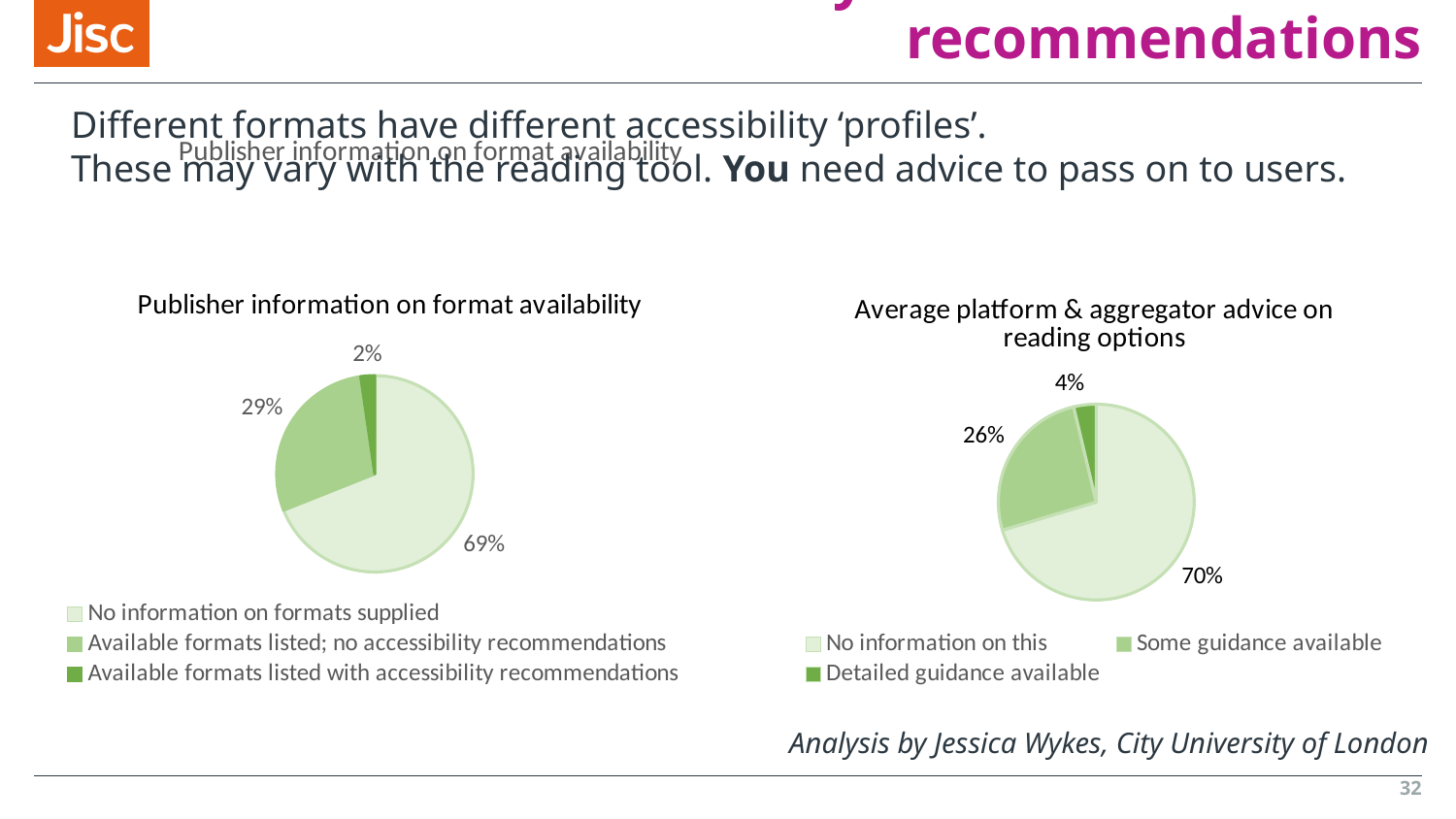
In the 'Publisher information on format availability' chart, which category has the smallest slice? Available formats listed with accessibility recommendations In the 'Publisher information on format availability' chart, how many categories does the legend list? 3 In the 'Average platform & aggregator advice on reading options' chart, what percentage is shown for 'Some guidance available'? 26% In the 'Average platform & aggregator advice on reading options' chart, what is the difference in percentage points between 'No information on this' and 'Some guidance available'? 44 In the 'Publisher information on format availability' chart, what percentage is shown for 'Available formats listed; no accessibility recommendations'? 29% What kind of chart is used for 'Average platform & aggregator advice on reading options'? Pie chart In the 'Average platform & aggregator advice on reading options' chart, what percentage is shown for 'Detailed guidance available'? 4% Which is larger: the 'Detailed guidance available' slice in the right-hand chart or the 'Available formats listed with accessibility recommendations' slice in the left-hand chart? Detailed guidance available In the 'Publisher information on format availability' chart, what percentage is shown for 'Available formats listed with accessibility recommendations'? 2% In the 'Average platform & aggregator advice on reading options' chart, what percentage is shown for 'No information on this'? 70% In the 'Publisher information on format availability' chart, which category has the largest slice? No information on formats supplied In the 'Publisher information on format availability' chart, what share of the pie is 'No information on formats supplied'? 69%